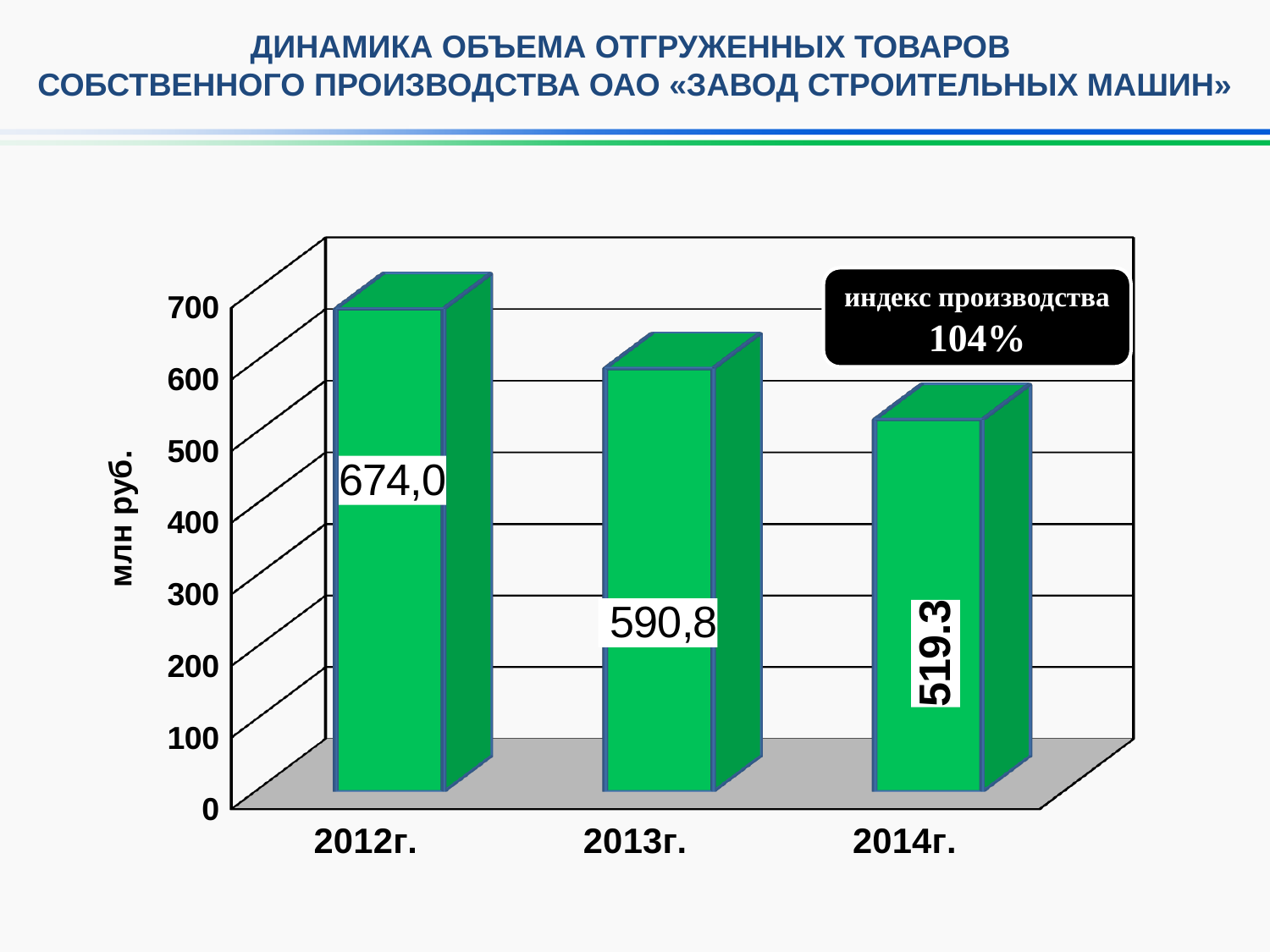
What is the difference between the values for 2013г. and 2014г.? 71,5 What is the value for 2013г.? 590,8 Which is larger, the value for 2013г. or the value for 2014г.? 2013г. Do the values rise or fall from 2012г. to 2014г.? fall What unit is shown on the y axis label? млн руб. What kind of chart is shown on the slide? bar chart What is the value for 2012г.? 674,0 What is the value for 2014г.? 519.3 Which year has the highest value? 2012г. How many years are shown on the x axis? 3 Which year has the lowest value? 2014г. What is the difference between the values for 2012г. and 2013г.? 83,2